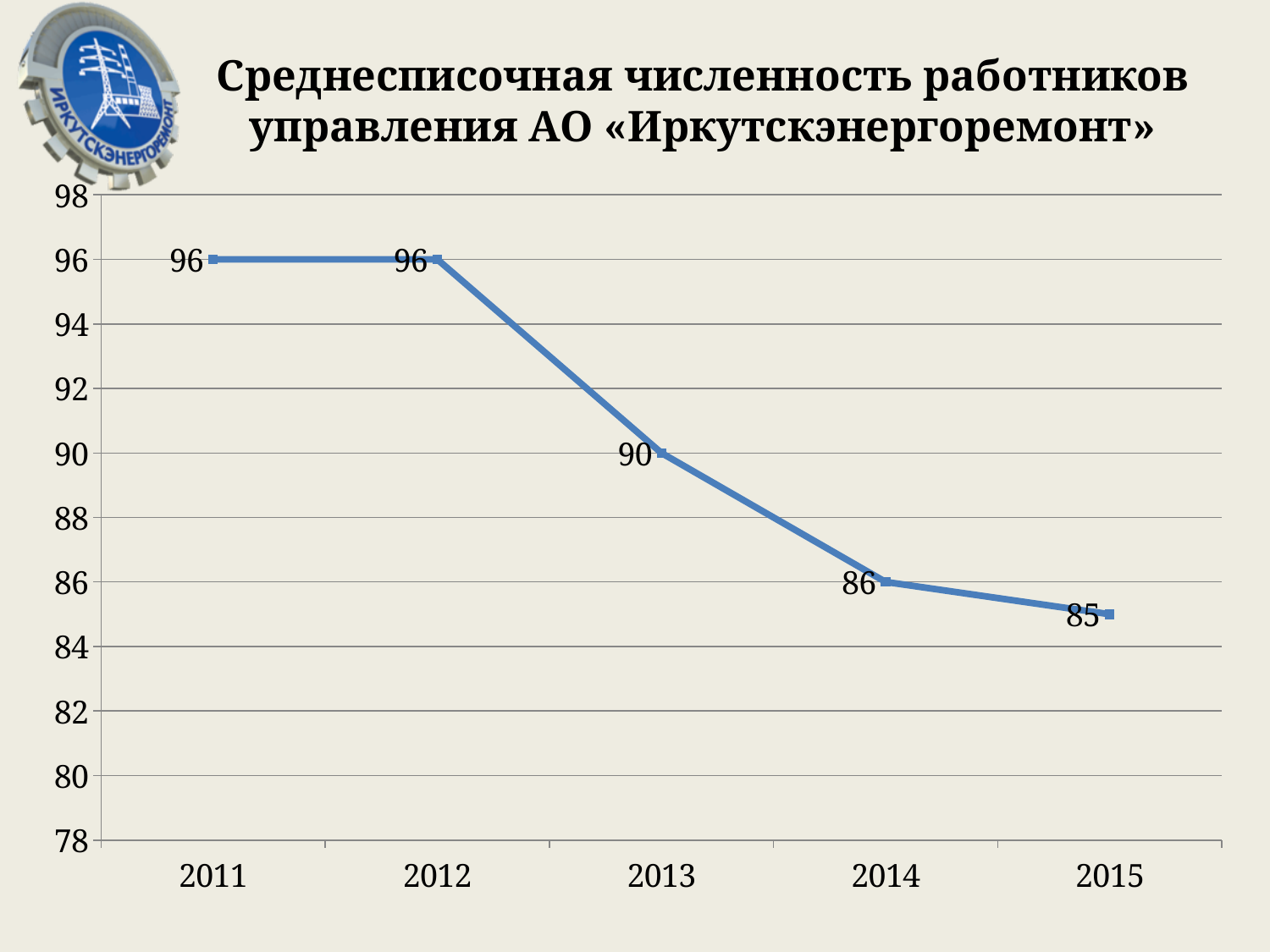
What is the difference between the values for 2012 and 2013? 6 What is the value for 2015? 85 Which year has the lowest value? 2015 What is the value for 2013? 90 Which is larger, the value for 2013 or the value for 2014? 2013 Do the values rise or fall from 2012 to 2015? fall What kind of chart is shown on the slide? line chart What is the difference between the values for 2011 and 2015? 11 Is the value for 2013 greater or less than 88? greater What is the title of the chart? Среднесписочная численность работников управления АО «Иркутскэнергоремонт» What is the value for 2014? 86 How many years are plotted on the chart? 5